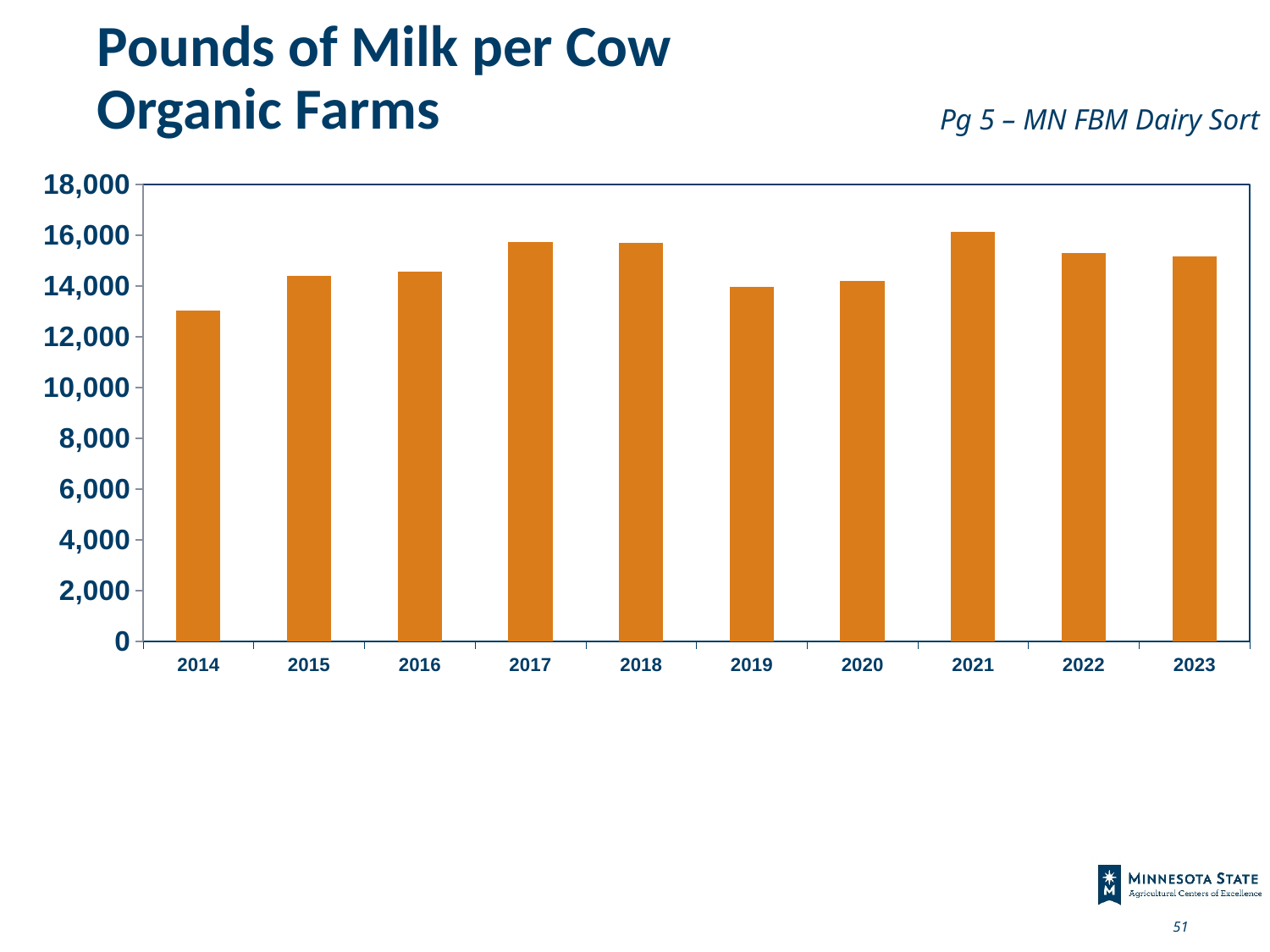
Is the value for 2015 greater or less than 16,000? less Which year has a higher value, 2014 or 2015? 2015 Is the value for 2014 greater or less than 14,000? less Do the values rise or fall from 2014 to 2017? rise Is the value for 2017 greater or less than 14,000? greater What is the title of the chart on the slide? Pounds of Milk per Cow Organic Farms Which year has the highest pounds of milk per cow? 2021 How many years are shown on the x axis of the chart? 10 Which year has a higher value, 2019 or 2021? 2021 Which year has the lowest pounds of milk per cow? 2014 What kind of chart is shown on the slide? bar chart